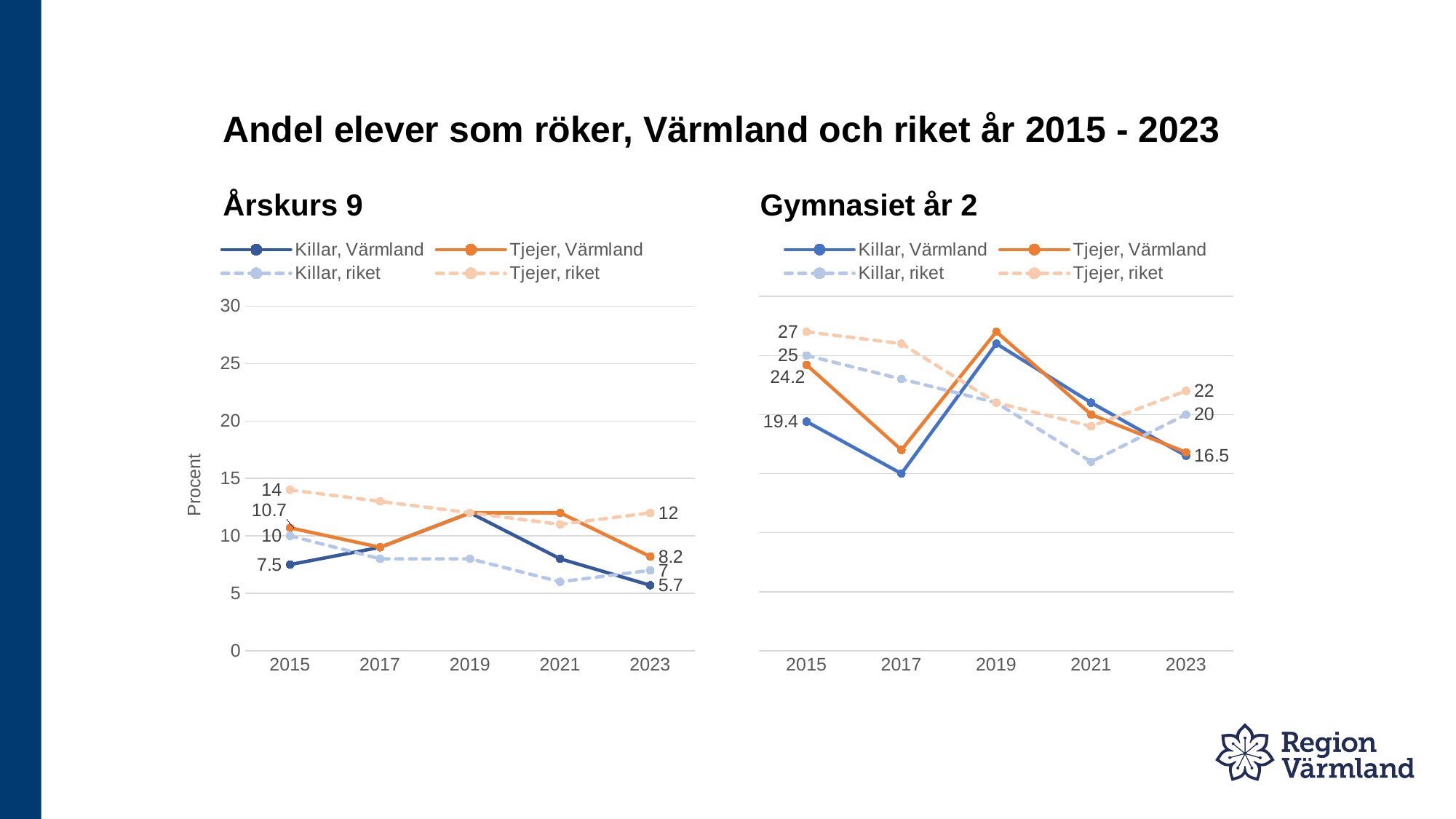
In the Gymnasiet år 2 chart, what is the value for Killar, Värmland in 2015? 19.4 In the Gymnasiet år 2 chart, what is the difference between the Tjejer, riket values in 2015 and 2023? 5 In the Gymnasiet år 2 chart, which series has the highest value in 2015? Tjejer, riket How many years are shown on the x axis of the Gymnasiet år 2 chart? 5 In the Årskurs 9 chart, what is the value for Killar, Värmland in 2015? 7.5 In the Årskurs 9 chart, which series has the lowest value in 2023? Killar, Värmland How many series does the legend of the Årskurs 9 chart list? 4 In the Årskurs 9 chart, is the value for Tjejer, riket in 2017 greater or less than 10? greater In the Årskurs 9 chart, what is the value for Tjejer, riket in 2023? 12 What kind of chart is the Gymnasiet år 2 chart? line chart In the Årskurs 9 chart, what is the difference between Tjejer, Värmland and Killar, Värmland in 2023? 2.5 In the Årskurs 9 chart, is the value for Killar, riket in 2021 greater or less than 10? less